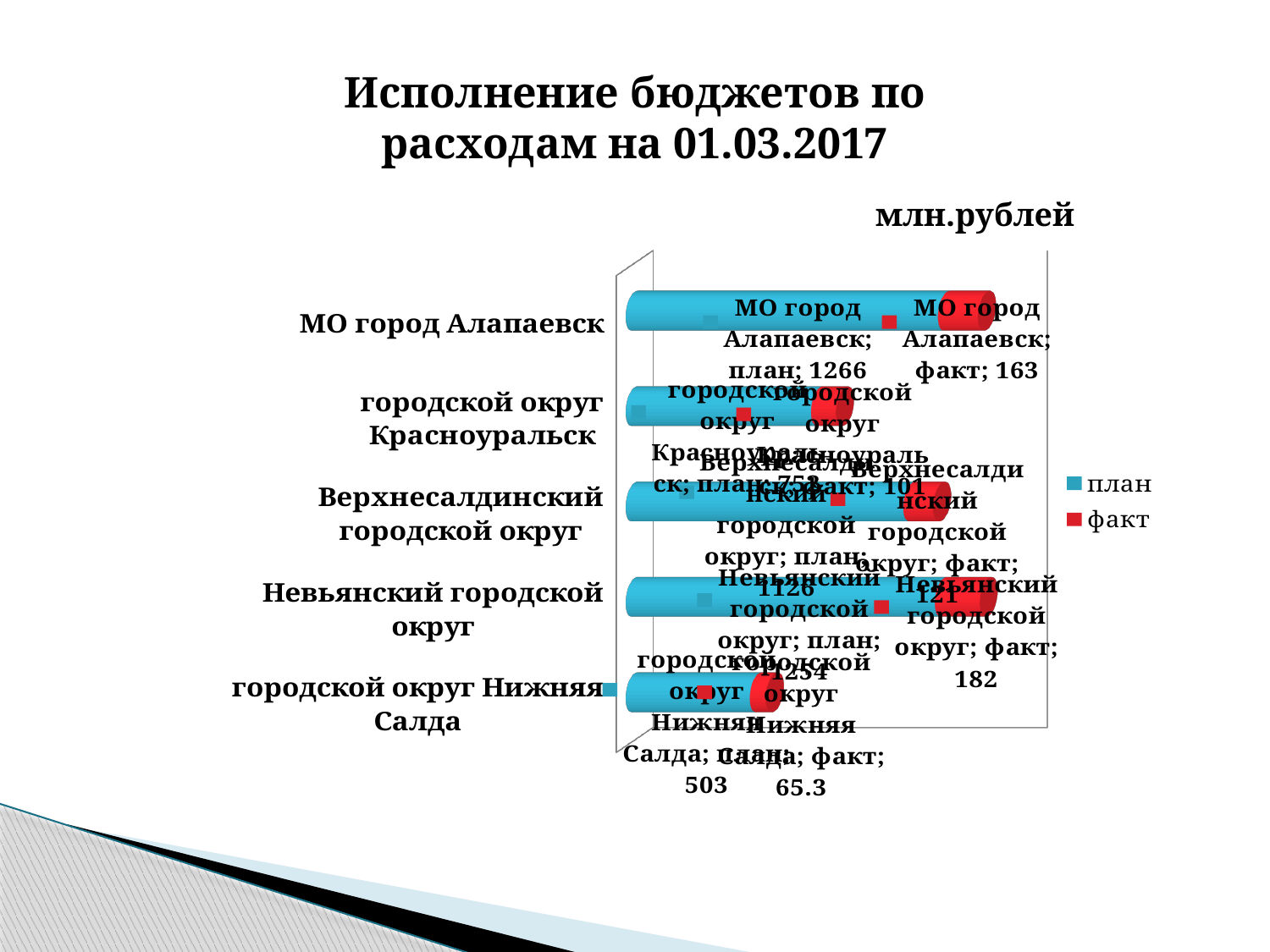
What is the план value for городской округ Нижняя Салда? 503 What are the two series named in the legend? план and факт How many municipalities (categories) are shown on the chart? 5 What type of chart is shown on the slide? bar chart What is the факт value for МО город Алапаевск? 163 Which municipality has the highest факт value? Невьянский городской округ What is the план value for МО город Алапаевск? 1266 Which municipality has the lowest план value? городской округ Нижняя Салда What is the difference between the план and факт values for МО город Алапаевск? 1103 What is the факт value for Невьянский городской округ? 182 How many series does the legend list? 2 What is the факт value for городской округ Нижняя Салда? 65.3